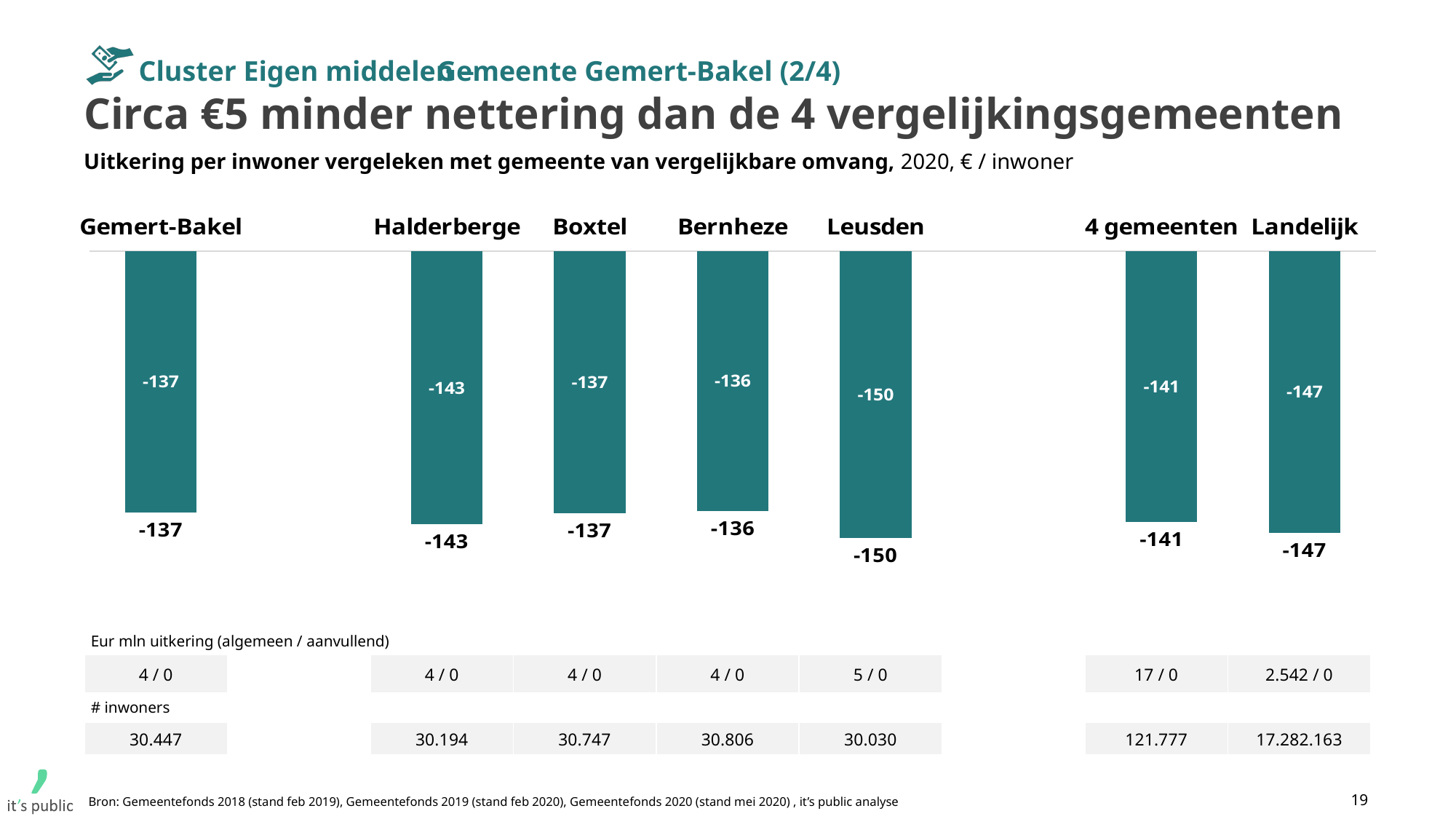
What is the value for Gemert-Bakel? -137 Which category has the lowest (most negative) value? Leusden What is the value for Leusden? -150 What is the difference between the values for Leusden and Bernheze? 14 What is the value for Landelijk? -147 Which category has the value closest to zero (the highest value)? Bernheze What unit is stated in the chart subtitle for the plotted values? € / inwoner Which has the higher (less negative) value, Halderberge or Boxtel? Boxtel What is the difference between the values for Gemert-Bakel and 4 gemeenten? 4 What kind of chart is shown on the slide? Bar chart What is the value for 4 gemeenten? -141 How many bars are shown in the chart? 7